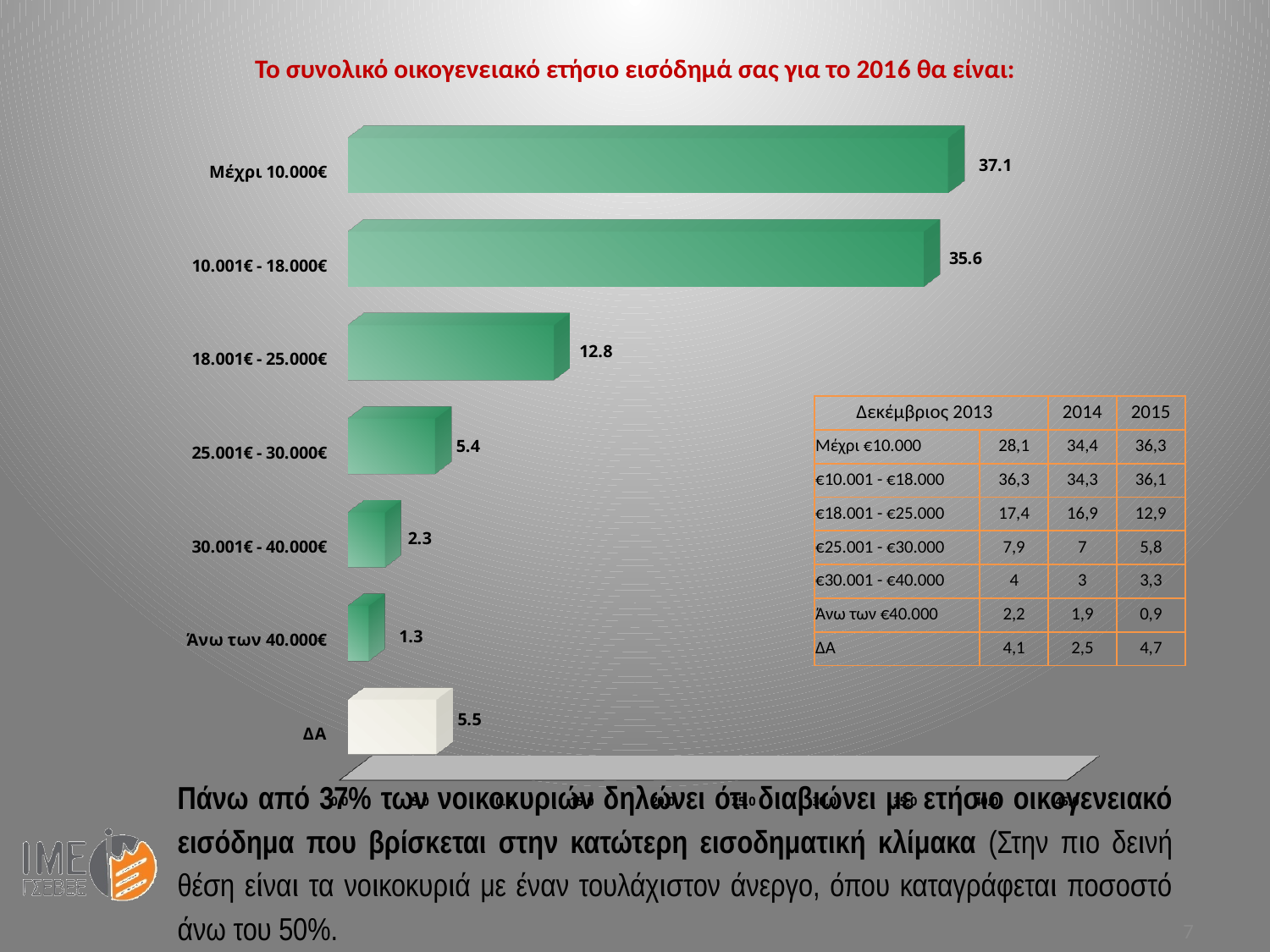
What is the difference between the values for 'Μέχρι 10.000€' and '10.001€ - 18.000€'? 1.5 What value is shown for the category '10.001€ - 18.000€'? 35.6 Which is larger, the value for 'ΔΑ' or the value for '25.001€ - 30.000€'? ΔΑ What is the difference between the values for '18.001€ - 25.000€' and '25.001€ - 30.000€'? 7.4 Which category has the highest value in the chart? Μέχρι 10.000€ What value is shown for the category '18.001€ - 25.000€'? 12.8 What type of chart is shown on the slide? Bar chart What value is shown for the category 'Μέχρι 10.000€'? 37.1 Which category has the lowest value in the chart? Άνω των 40.000€ How many categories are shown in the bar chart? 7 What is the title of the chart? Το συνολικό οικογενειακό ετήσιο εισόδημά σας για το 2016 θα είναι: What value is shown for the category 'ΔΑ'? 5.5